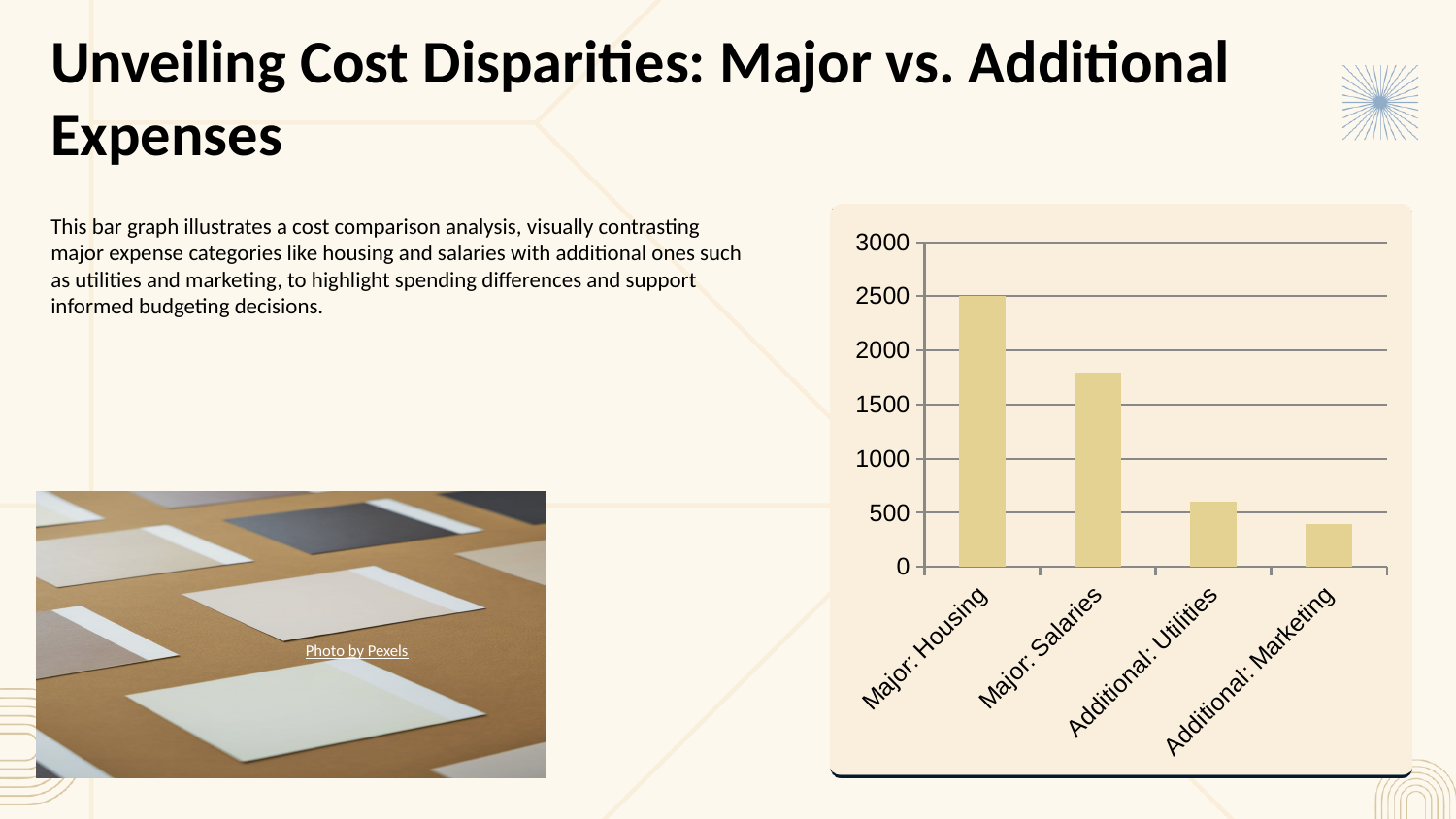
What kind of chart is shown on the slide? bar chart What is the highest value shown on the vertical axis of the bar chart? 3000 Is the value for Additional: Utilities greater or less than 500? greater How many categories are plotted in the bar chart? 4 Do the values rise or fall moving from left to right along the x axis? fall Is the value for Major: Salaries greater or less than 1500? greater Which category has the highest value in the bar chart? Major: Housing What is the value for Major: Housing? 2500 Is the value for Additional: Marketing greater or less than 500? less Which category has the lowest value in the bar chart? Additional: Marketing Which is larger, the value for Major: Salaries or the value for Additional: Utilities? Major: Salaries